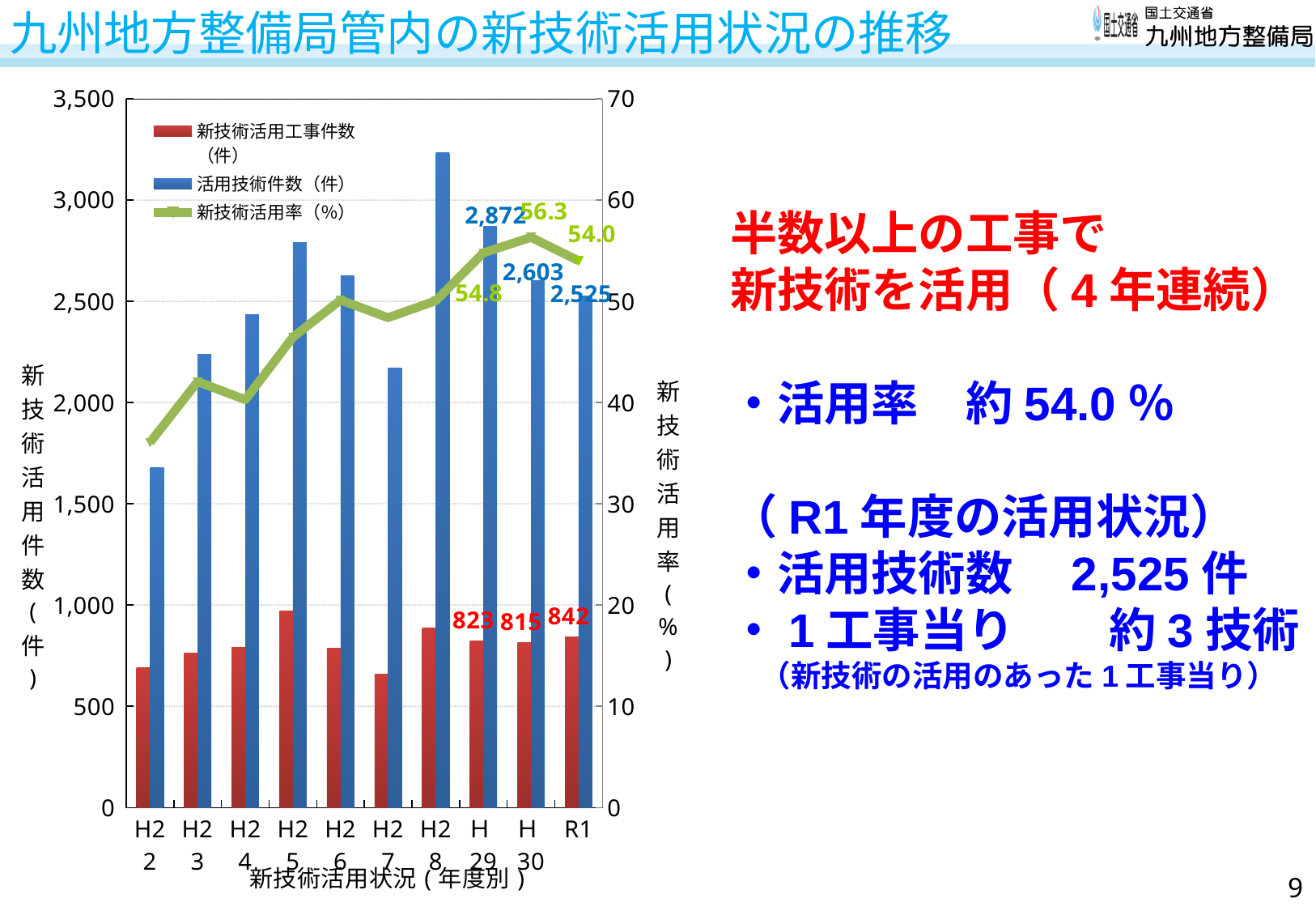
What is the 新技術活用率（%） for R1? 54.0 Is the 活用技術件数 value for H28 greater or less than 3,000? greater Which fiscal year has the lowest 活用技術件数（件）? H22 What is the 新技術活用率（%） for H30? 56.3 What kind of chart is shown on the slide? A combined bar and line chart What is the value of 活用技術件数（件） for H29? 2,872 What is the value of 新技術活用工事件数（件） for R1? 842 What is the difference between the 新技術活用工事件数 values for R1 and H30? 27 How many fiscal-year categories are shown on the x axis? 10 How many series does the legend list? 3 What is the difference between the 活用技術件数 values for H29 and H30? 269 Which fiscal year has the highest 活用技術件数（件）? H28